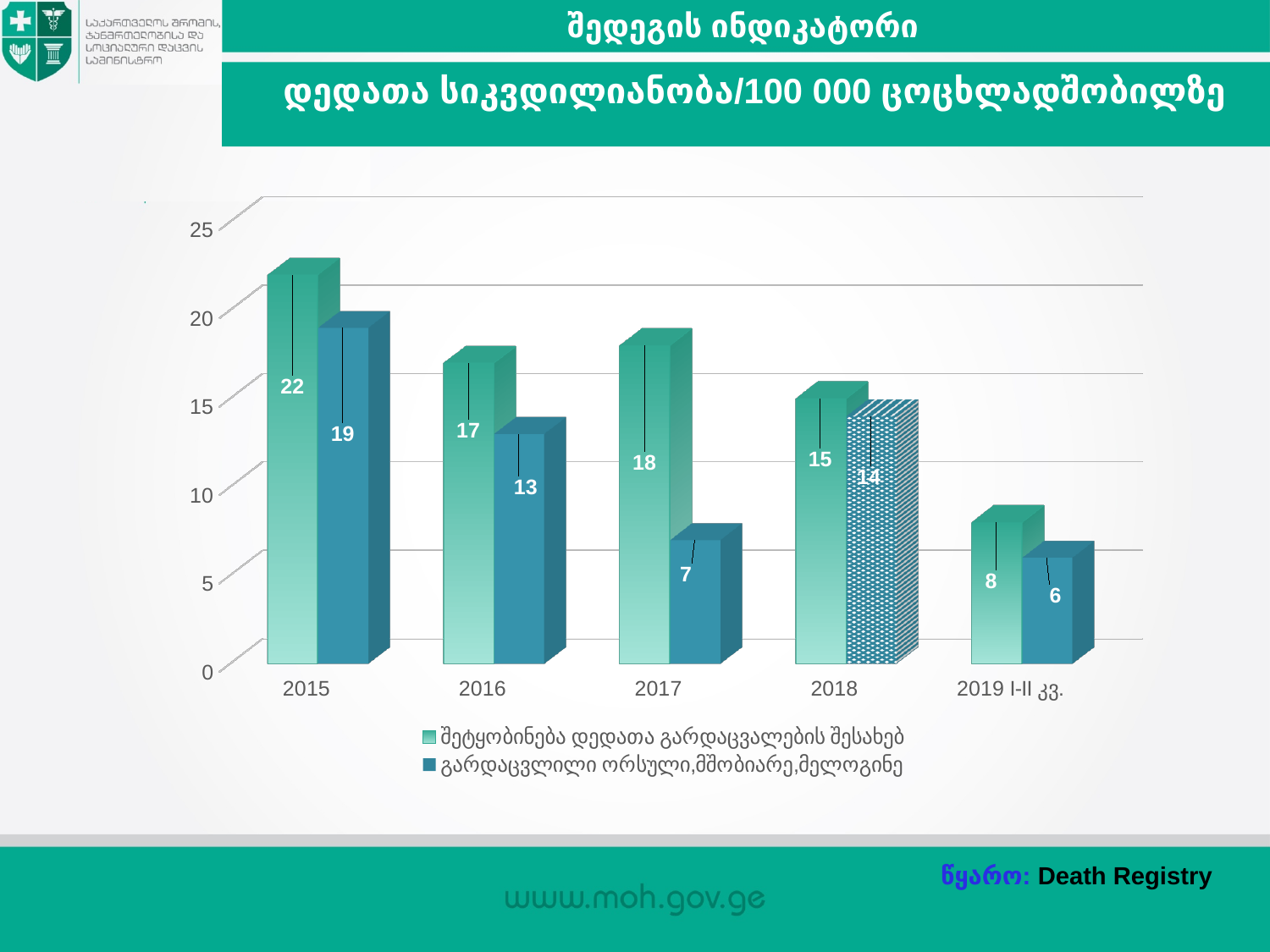
What is the value of the blue series (გარდაცვლილი ორსული,მშობიარე,მელოგინე) for 2017? 7 What is the title of the chart shown on the slide? დედათა სიკვდილიანობა/100 000 ცოცხლადშობილზე In which category is the blue series (გარდაცვლილი ორსული,მშობიარე,მელოგინე) lowest? 2019 I-II კვ. How many categories are shown on the x axis of the chart? 5 What is the value of the blue series (გარდაცვლილი ორსული,მშობიარე,მელოგინე) for 2019 I-II კვ.? 6 What type of chart is shown on the slide? bar chart What is the value of the light green series (შეტყობინება დედათა გარდაცვალების შესახებ) for 2015? 22 How many series does the legend list? 2 In which year is the light green series (შეტყობინება დედათა გარდაცვალების შესახებ) highest? 2015 Which is larger in 2016: the light green series value or the blue series value? the light green series (17) Does the light green series (შეტყობინება დედათა გარდაცვალების შესახებ) generally rise or fall from 2015 to 2019 I-II კვ.? fall What is the difference between the two series in 2017? 11